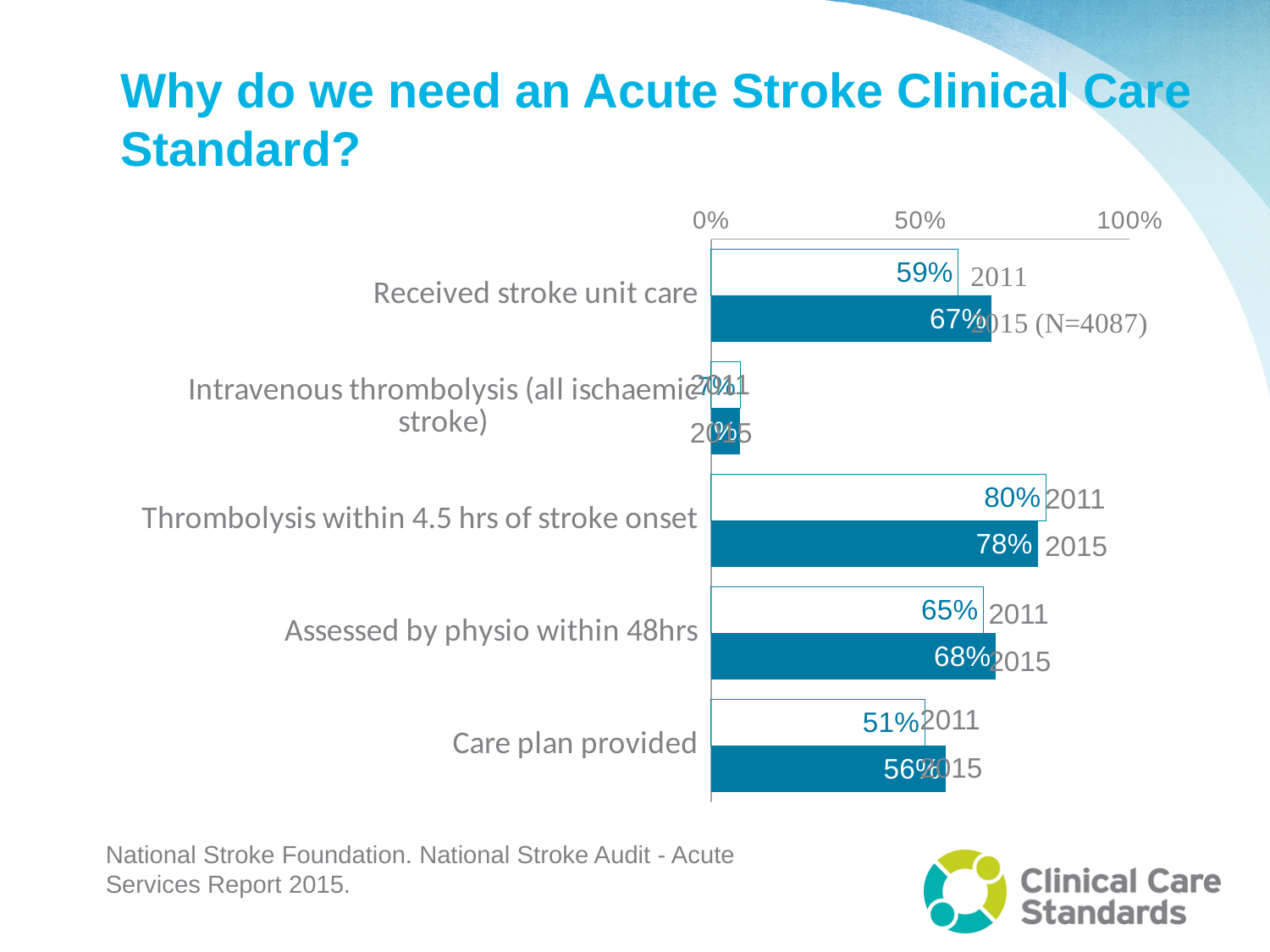
How many categories are shown on the chart? 5 Which category had the highest value in 2015? Thrombolysis within 4.5 hrs of stroke onset Which category had the lowest value in 2015? Intravenous thrombolysis (all ischaemic stroke) By how many percentage points did Care plan provided increase from 2011 to 2015? 5 percentage points What was the value for Care plan provided in 2011? 51% What was the value for Thrombolysis within 4.5 hrs of stroke onset in 2011? 80% Is the 2015 value for Intravenous thrombolysis (all ischaemic stroke) greater or less than 50%? less What was the value for Received stroke unit care in 2015? 67% What was the value for Assessed by physio within 48hrs in 2015? 68% What was the value for Received stroke unit care in 2011? 59% What kind of chart is shown on the slide? Bar chart For Thrombolysis within 4.5 hrs of stroke onset, which year had the higher value, 2011 or 2015? 2011